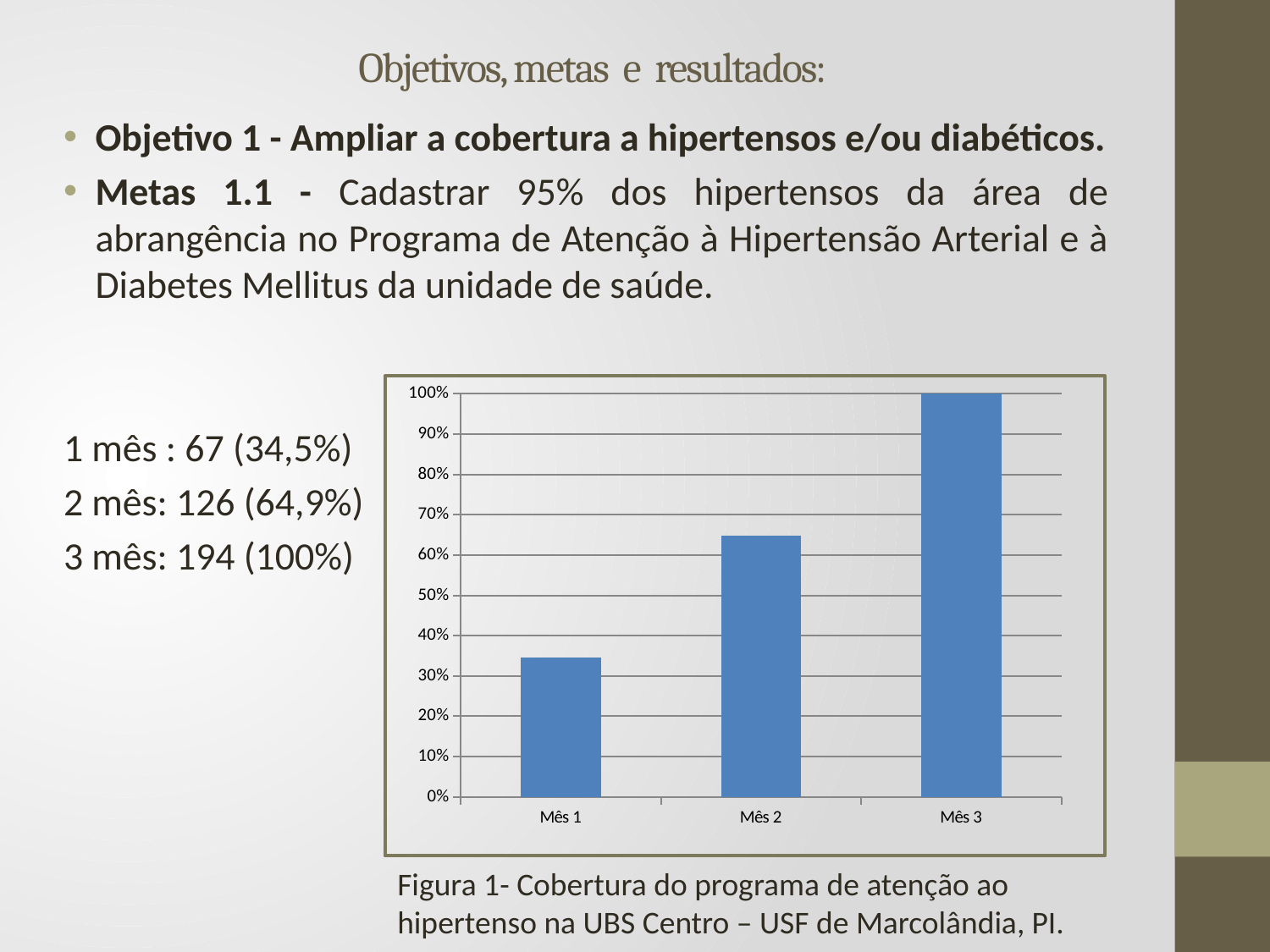
Is the value for Mês 1 greater or less than 40%? less What is the caption given for the chart (Figura 1)? Cobertura do programa de atenção ao hipertenso na UBS Centro – USF de Marcolândia, PI. According to the slide, what percentage coverage was reached in the 2nd month (Mês 2)? 64,9% What kind of chart is shown on the slide? bar chart Which month has the lowest coverage in the chart? Mês 1 According to the slide, what percentage coverage was reached in the 1st month (Mês 1)? 34,5% How many bars (categories) does the chart show? 3 What is the coverage value for Mês 3 in the chart? 100% Is the value for Mês 2 greater or less than 60%? greater Which is larger, the value for Mês 2 or the value for Mês 1? Mês 2 Do the values rise or fall from Mês 1 to Mês 3? rise Which month has the highest coverage in the chart? Mês 3